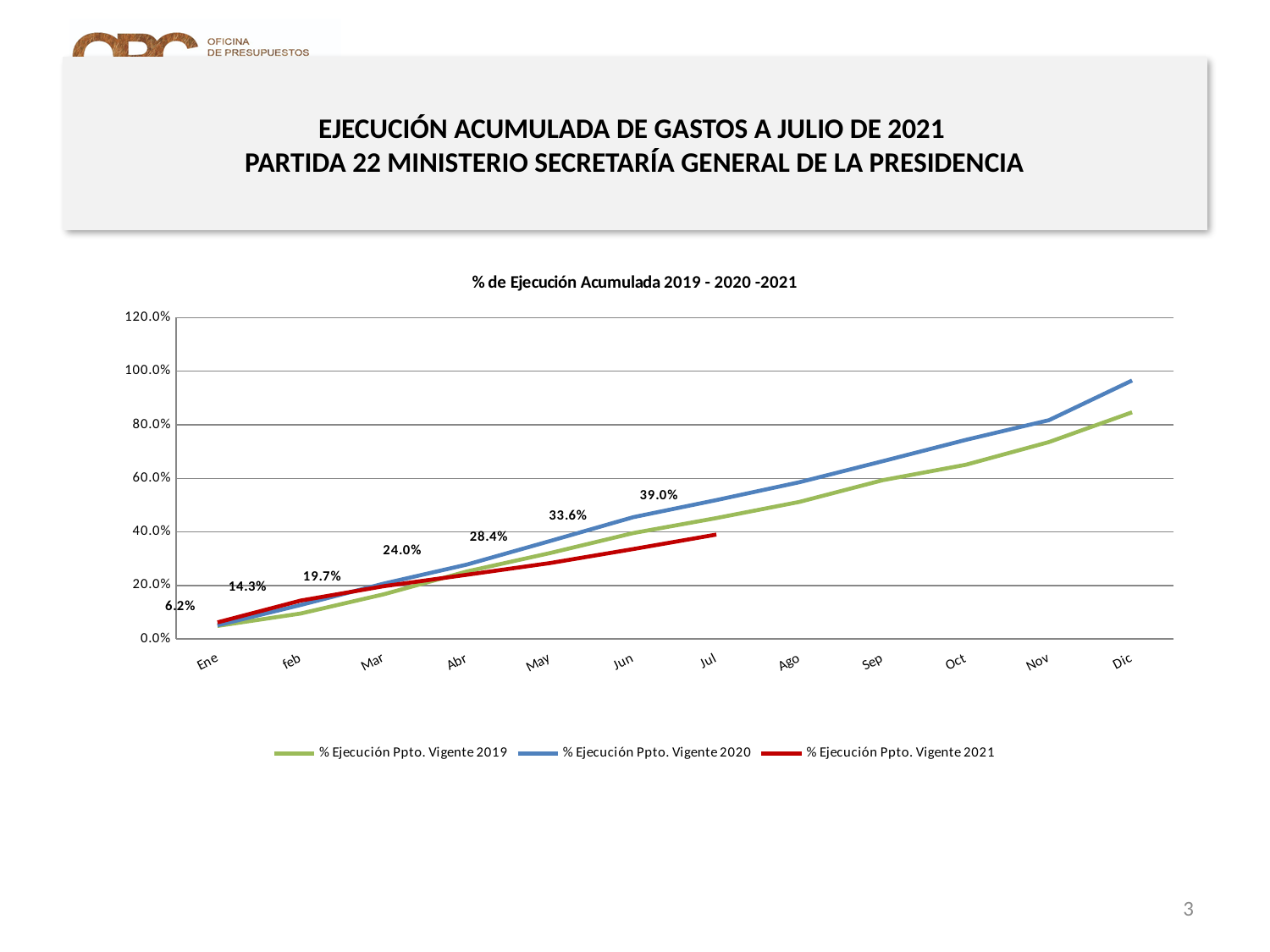
What is the value of % Ejecución Ppto. Vigente 2021 in Abr? 24.0% What is the title of the chart? % de Ejecución Acumulada 2019 - 2020 -2021 What kind of chart is shown on the slide? line chart In Dic, which series is higher: % Ejecución Ppto. Vigente 2019 or % Ejecución Ppto. Vigente 2020? % Ejecución Ppto. Vigente 2020 What is the value of % Ejecución Ppto. Vigente 2021 in Jul? 39.0% How many series does the legend list? 3 Is the value for % Ejecución Ppto. Vigente 2020 in Dic greater or less than 80.0%? greater What is the difference between the % Ejecución Ppto. Vigente 2021 values for Mar and Feb? 5.4% What is the difference between the % Ejecución Ppto. Vigente 2021 values for Jul and Jun? 5.4% What is the value of % Ejecución Ppto. Vigente 2021 in May? 28.4% Does the % Ejecución Ppto. Vigente 2021 series rise or fall from Ene to Jul? rise What is the value of % Ejecución Ppto. Vigente 2021 in Ene? 6.2%